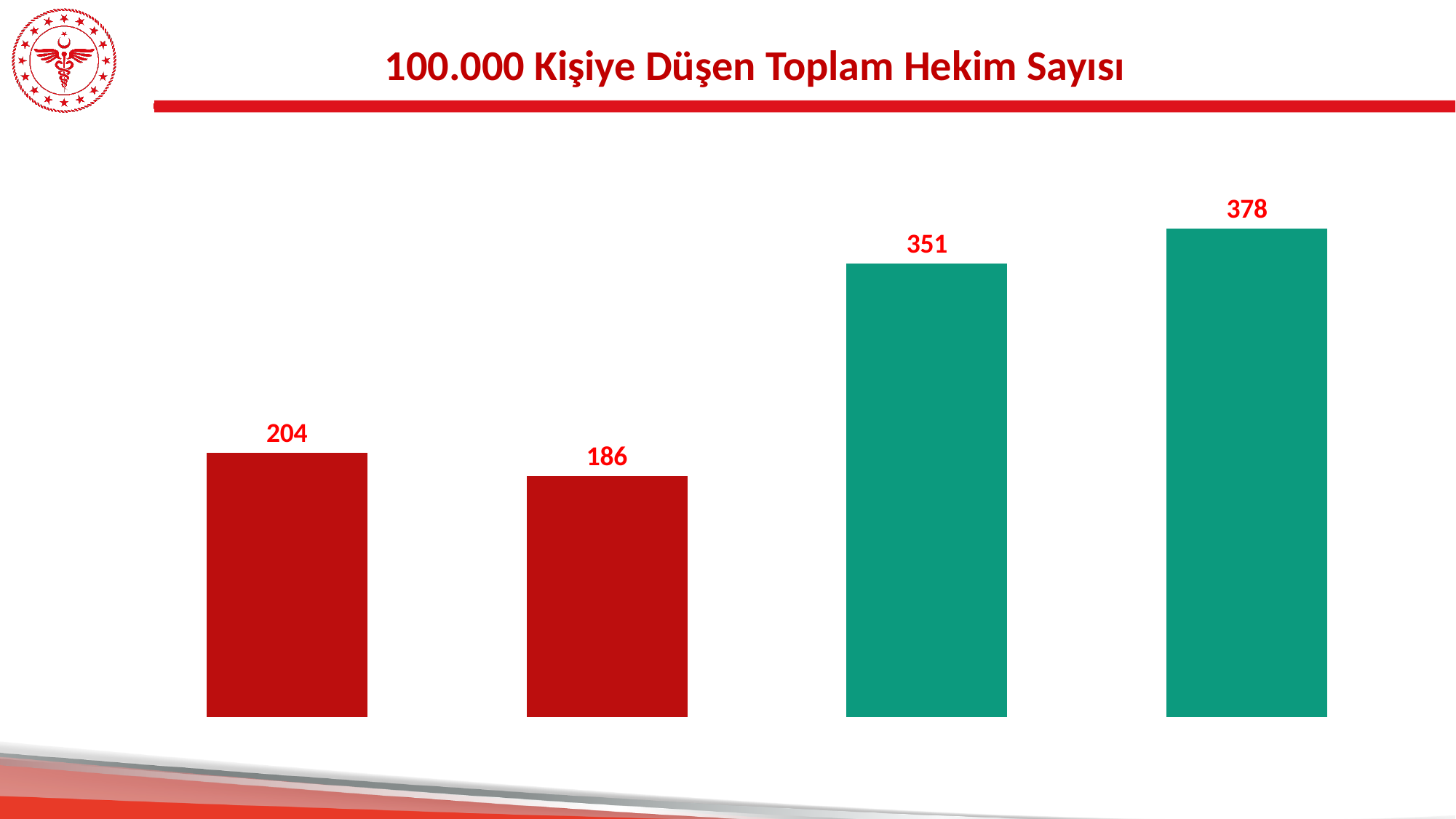
How many bars are plotted in the chart? 4 What is the difference between the rightmost bar and the leftmost bar? 174 What is the title of the chart? 100.000 Kişiye Düşen Toplam Hekim Sayısı What is the value of the first bar from the left? 204 Which bar has the lowest value? the second bar from the left (186) Which is larger, the first bar from the left or the second bar from the left? the first bar (204) What is the value of the third bar from the left? 351 Which bar has the highest value? the rightmost bar (378) What is the value of the rightmost bar? 378 What type of chart is shown on the slide? bar chart What colour are the two bars on the right side of the chart? green What is the value of the second bar from the left? 186